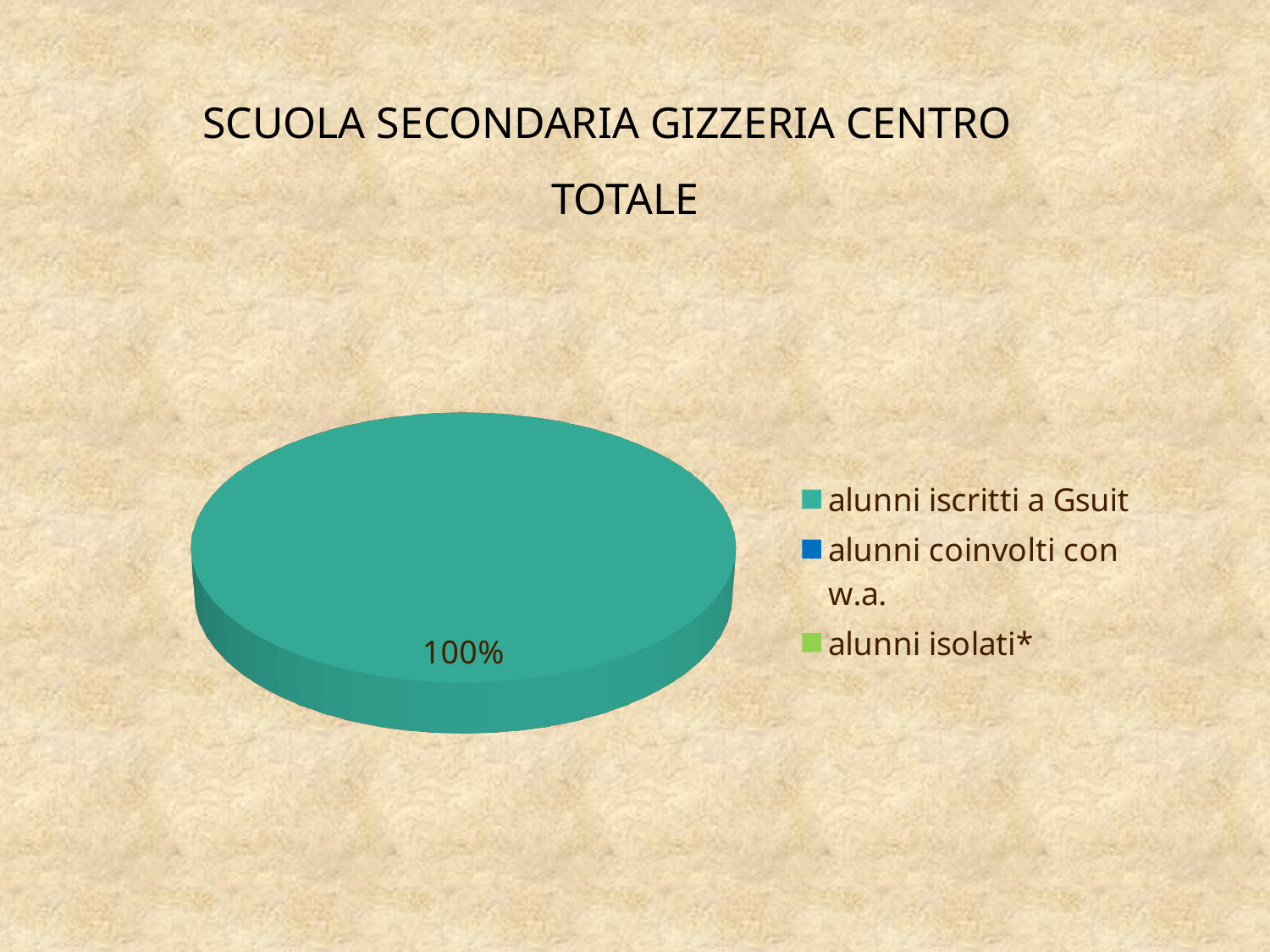
What is the title of the chart? SCUOLA SECONDARIA GIZZERIA CENTRO TOTALE What share of the pie does "alunni iscritti a Gsuit" take? 100% Is the share for "alunni iscritti a Gsuit" greater or less than 50%? greater What colour is the slice for "alunni iscritti a Gsuit"? teal Which category takes the largest share of the pie? alunni iscritti a Gsuit What value is printed on the pie slice? 100% How many entries does the legend list? 3 How many slices are visible in the pie? 1 What kind of chart is shown on the slide? pie chart Which is larger, the share for "alunni iscritti a Gsuit" or the share for "alunni isolati*"? alunni iscritti a Gsuit